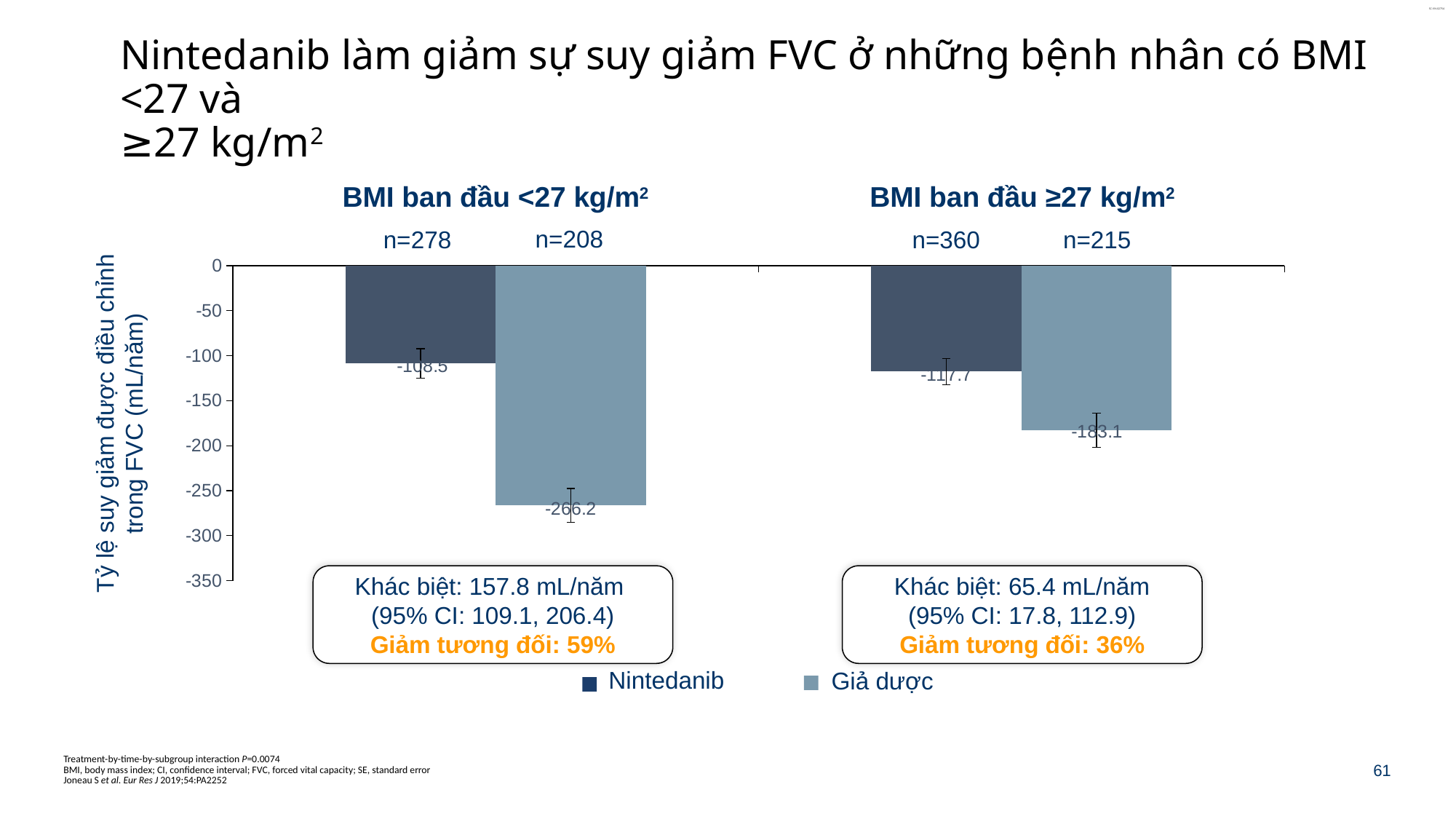
What kind of chart is shown on the slide? bar chart What is the n for the Nintedanib bar in the BMI ban đầu ≥27 kg/m² group? n=360 What is the value for Nintedanib in the BMI ban đầu <27 kg/m² group? -108.5 How many bars are plotted on the chart? 4 Which bar shows the lowest (most negative) value on the chart? Giả dược, BMI ban đầu <27 kg/m² What relative reduction (Giảm tương đối) is shown for the BMI ban đầu ≥27 kg/m² group? 36% What is the value for Giả dược in the BMI ban đầu <27 kg/m² group? -266.2 How many series does the legend list? 2 What is the difference (Khác biệt) stated for the BMI ban đầu <27 kg/m² group? 157.8 mL/năm What is the value for Nintedanib in the BMI ban đầu ≥27 kg/m² group? -117.7 What is the value for Giả dược in the BMI ban đầu ≥27 kg/m² group? -183.1 In the BMI ban đầu ≥27 kg/m² group, which has the larger decline in FVC, Nintedanib or Giả dược? Giả dược